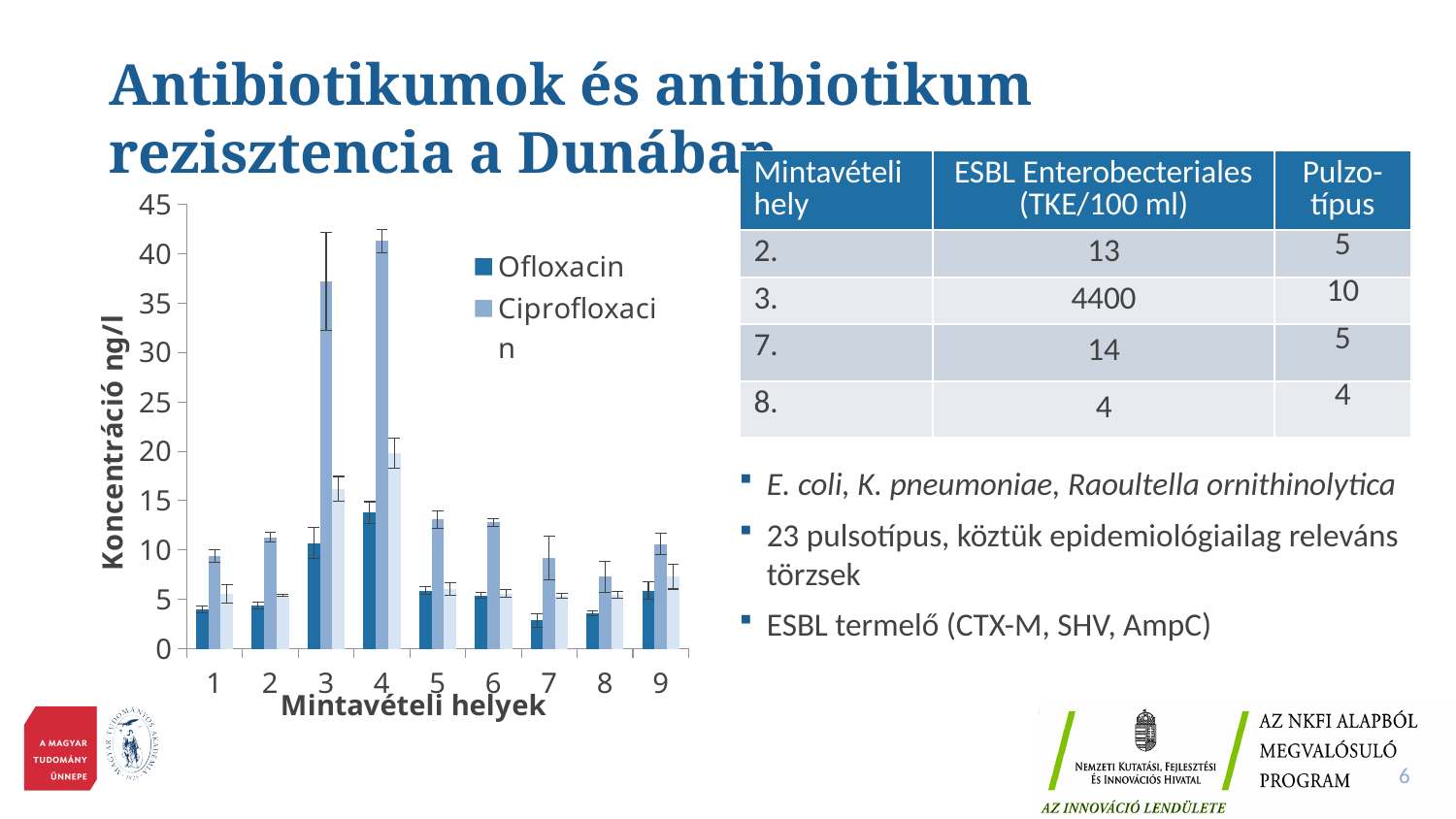
At which sampling site is the Ofloxacin concentration lowest? 7 What is the title of the chart's y axis? Koncentráció ng/l Which is larger: the Ciprofloxacin concentration at sampling site 3 or at sampling site 4? sampling site 4 Is the Ofloxacin concentration at sampling site 1 greater or less than 5 ng/l? less At sampling site 1, which is larger: the Ofloxacin or the Ciprofloxacin concentration? Ciprofloxacin Is the Ciprofloxacin concentration at sampling site 4 greater or less than 35 ng/l? greater At which sampling site is the Ciprofloxacin concentration highest? 4 How many sampling sites (Mintavételi helyek) are shown on the x axis of the chart? 9 Is the Ciprofloxacin concentration at sampling site 3 greater or less than 30 ng/l? greater What kind of chart is shown on the slide? bar chart At which sampling site is the Ofloxacin concentration highest? 4 How many series does the chart's legend list? 2